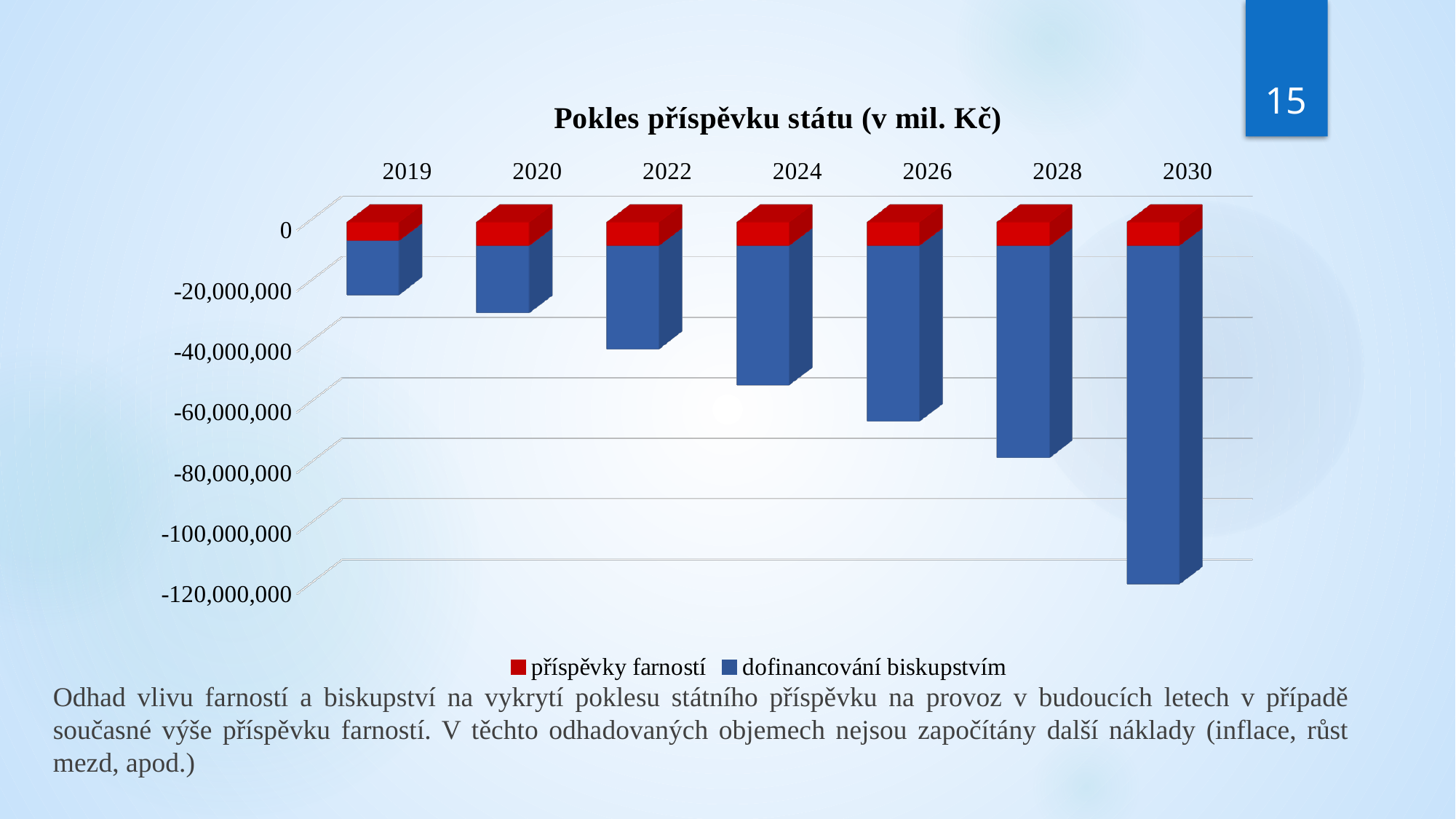
Which year has the shortest stacked bar (the smallest total decline)? 2019 Is the total value for 2024 greater or less than -60,000,000? greater What is the title of the chart? Pokles příspěvku státu (v mil. Kč) How many series does the legend list? 2 Which colour represents the series 'dofinancování biskupstvím'? blue Which year has the longest stacked bar (the largest total decline)? 2030 Which year has a longer stacked bar, 2020 or 2028? 2028 What kind of chart is shown on the slide? bar chart How many years are shown on the x axis of the chart? 7 Do the stacked bars get longer or shorter moving from 2019 to 2030? longer Is the total value for 2030 greater or less than -100,000,000? less Is the total value for 2020 greater or less than -40,000,000? greater